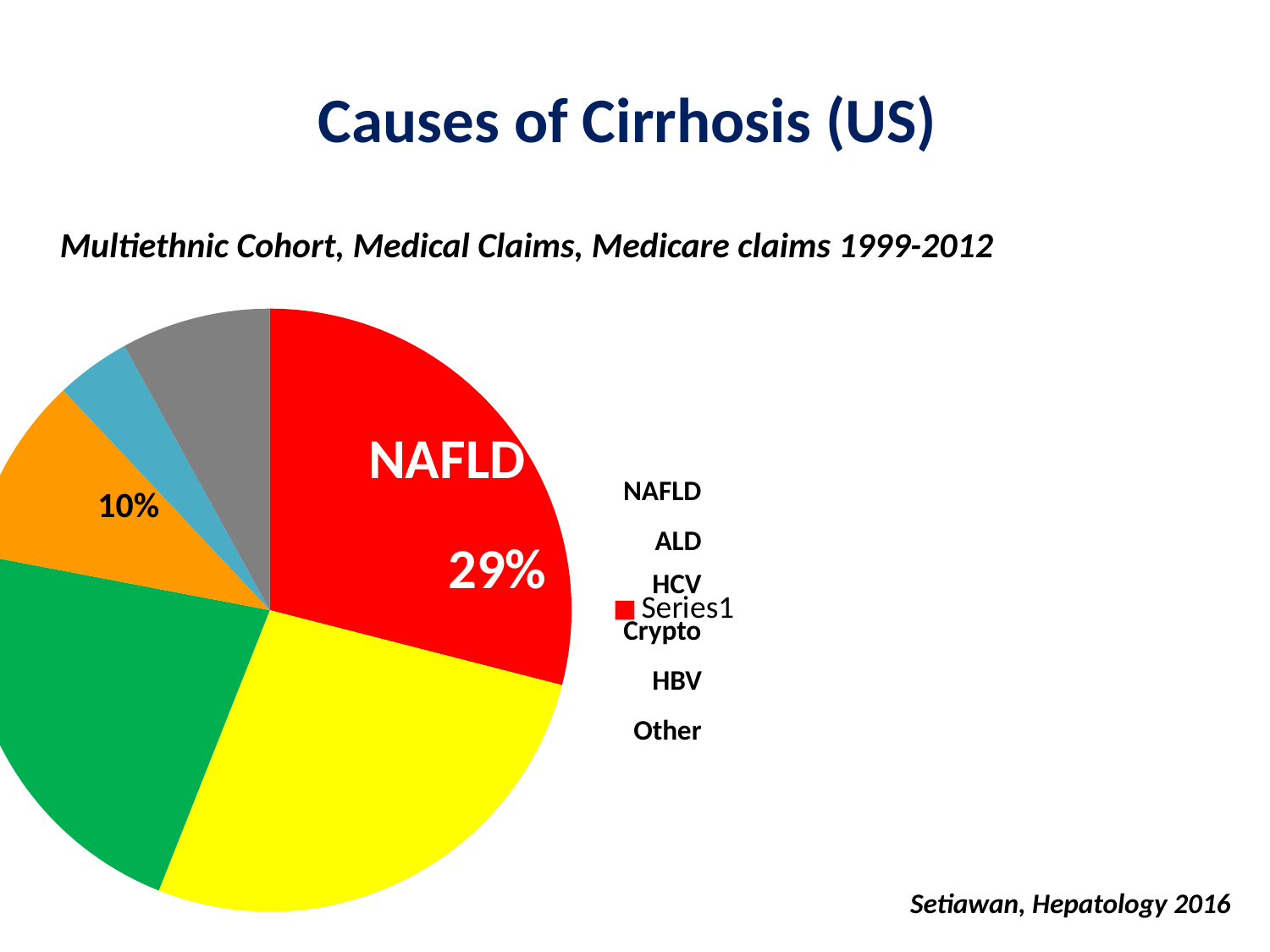
How many series does the legend list? 1 What share of the pie does the NAFLD slice represent? 29% What is the legend entry shown next to the pie chart? Series1 Which is larger, the red NAFLD slice or the orange slice? the red NAFLD slice How many slices does the pie chart have? 6 What kind of chart is shown on the slide? pie chart What is the difference between the NAFLD slice (29%) and the orange slice (10%)? 19% Which colour slice is the smallest in the pie chart? blue What percentage is printed on the orange slice of the pie? 10% What is the title of the chart on the slide? Causes of Cirrhosis (US) How many cause names are listed to the right of the pie chart? 6